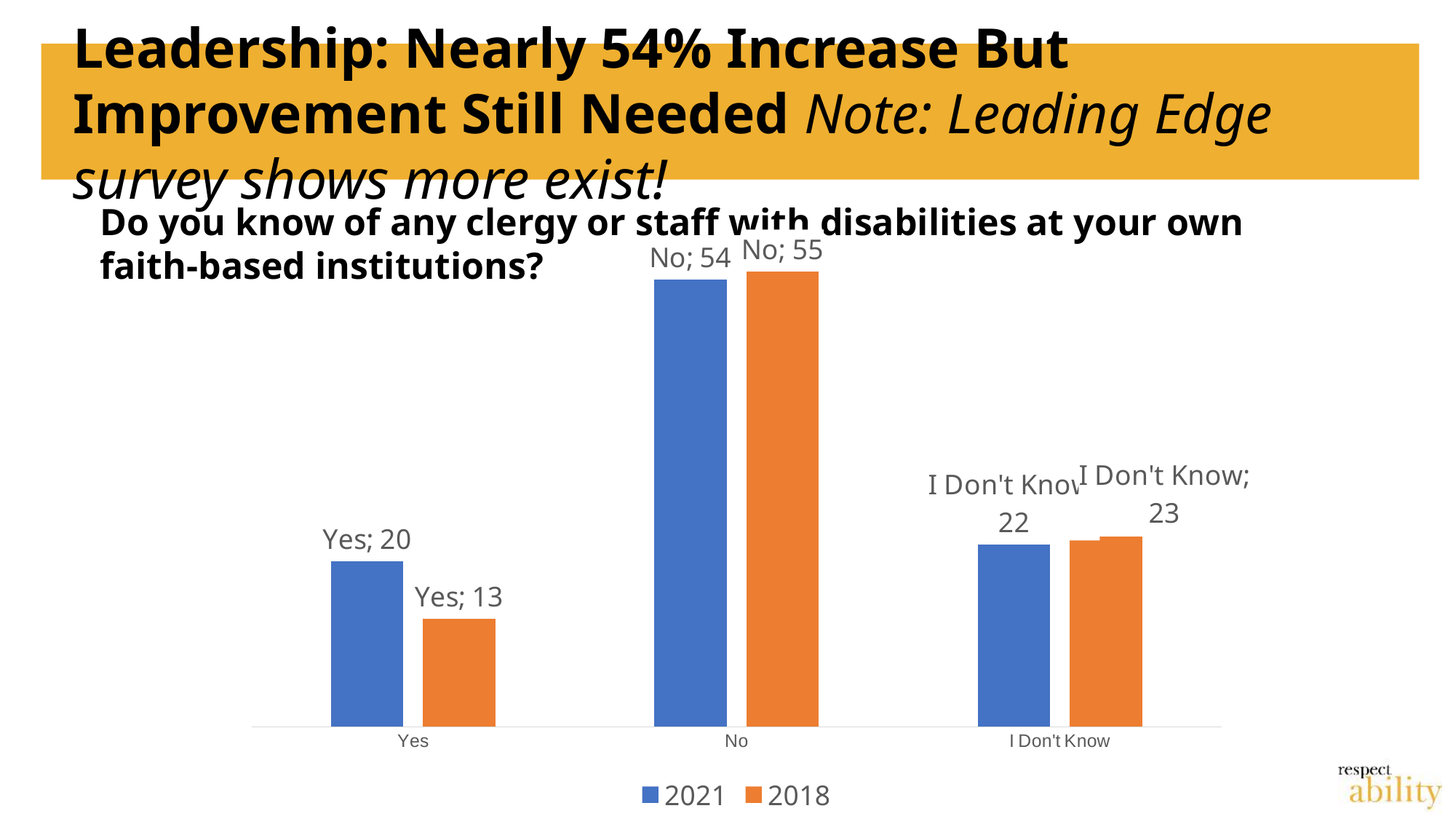
Which is larger for Yes: the 2021 value or the 2018 value? 2021 How many categories are shown on the x axis? 3 What is the value for I Don't Know in the 2018 series? 23 Which category has the lowest value in the 2018 series? Yes What is the value for Yes in the 2018 series? 13 What is the difference between the 2021 and 2018 values for Yes? 7 Which category has the highest value in the 2021 series? No What kind of chart is shown on the slide? Bar chart What is the value for No in the 2018 series? 55 What is the value for No in the 2021 series? 54 How many series does the legend list? 2 What is the value for Yes in the 2021 series? 20